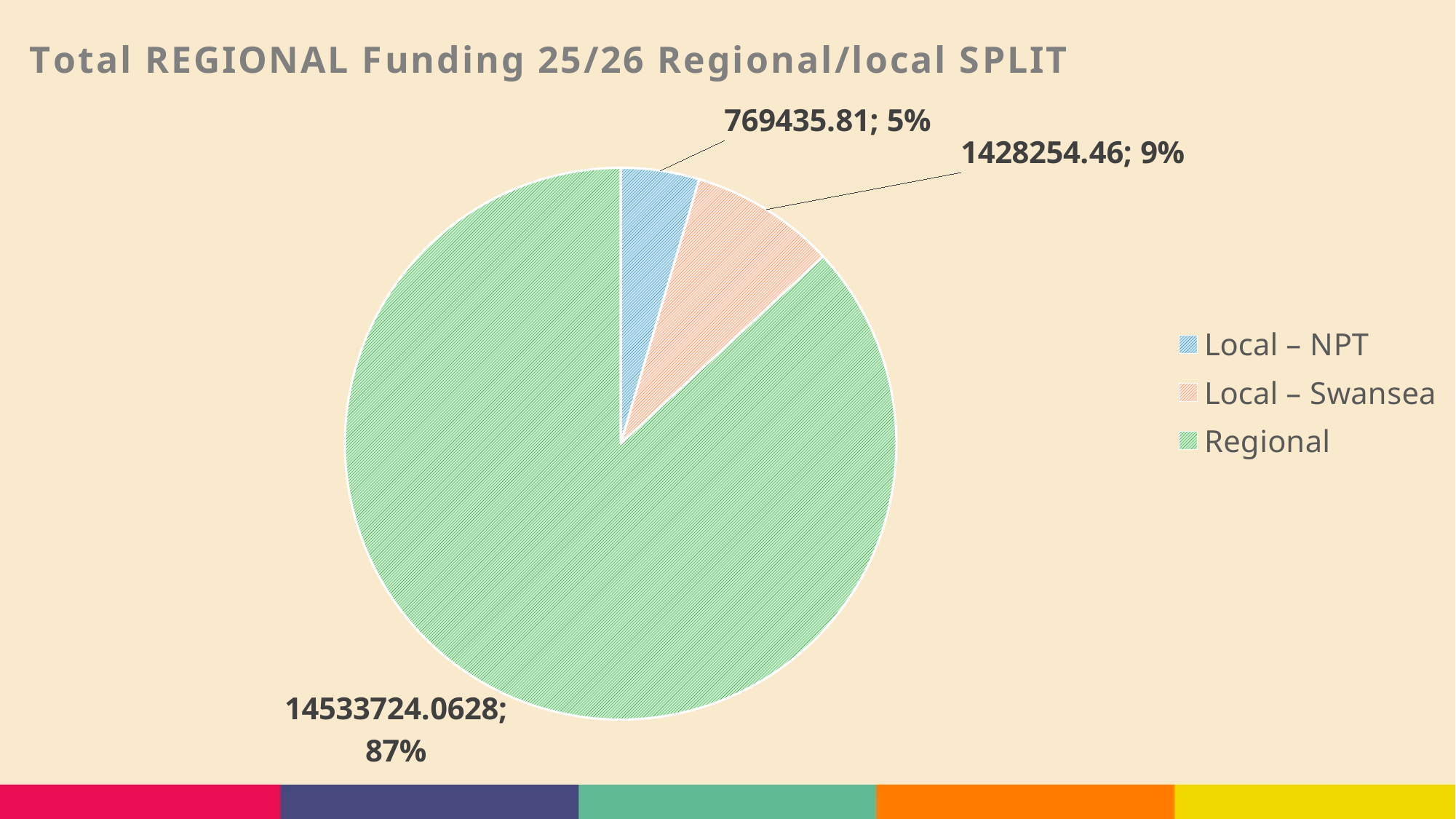
Which category has the smallest slice? Local – NPT What share of the pie does Local – NPT represent? 5% How many categories does the pie chart have? 3 What is the value for Local – NPT? 769435.81 What share of the pie does Regional represent? 87% Which category has the largest slice? Regional What is the title of the chart? Total REGIONAL Funding 25/26 Regional/local SPLIT What is the value for Local – Swansea? 1428254.46 Which is larger, Local – Swansea or Local – NPT? Local – Swansea What share of the pie does Local – Swansea represent? 9% What is the value for Regional? 14533724.0628 What type of chart is shown on the slide? Pie chart